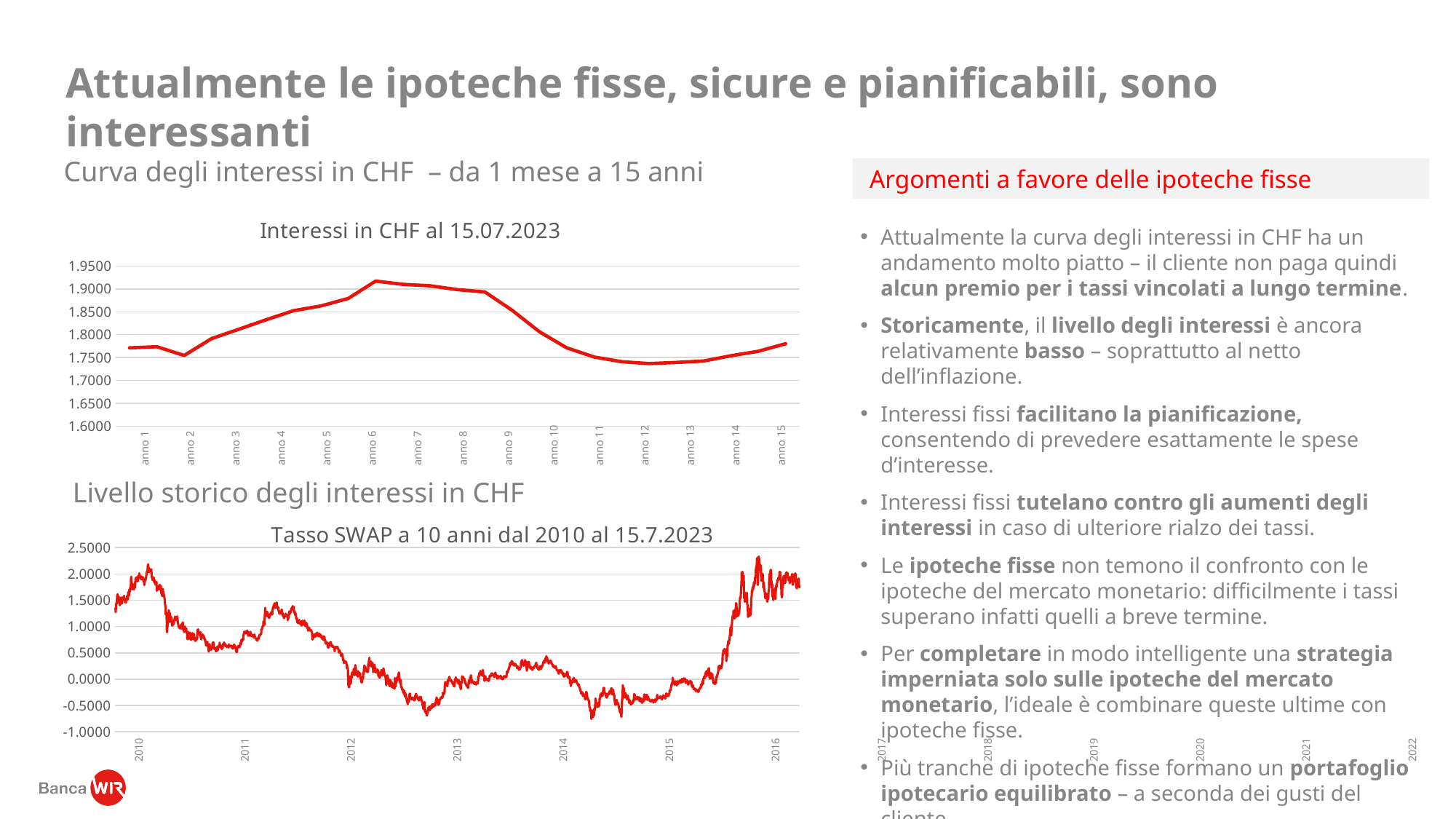
In the 'Interessi in CHF al 15.07.2023' chart, is the value for anno 6 greater or less than 1.9000? greater In the 'Interessi in CHF al 15.07.2023' chart, do the values rise or fall from anno 6 to anno 12? fall In the 'Tasso SWAP a 10 anni dal 2010 al 15.7.2023' chart, is the highest value reached greater or less than 2.0000? greater In the 'Interessi in CHF al 15.07.2023' chart, which category has the highest value? anno 6 How many categories are shown on the x axis of the 'Interessi in CHF al 15.07.2023' chart? 15 In the 'Interessi in CHF al 15.07.2023' chart, which is larger, the value for anno 4 or the value for anno 11? anno 4 In the 'Interessi in CHF al 15.07.2023' chart, which category has the lowest value? anno 12 What is the title of the lower chart on the slide? Tasso SWAP a 10 anni dal 2010 al 15.7.2023 In the 'Interessi in CHF al 15.07.2023' chart, is the value for anno 12 greater or less than 1.7500? less What kind of chart is the 'Tasso SWAP a 10 anni dal 2010 al 15.7.2023' chart? line chart What kind of chart is the 'Interessi in CHF al 15.07.2023' chart? line chart